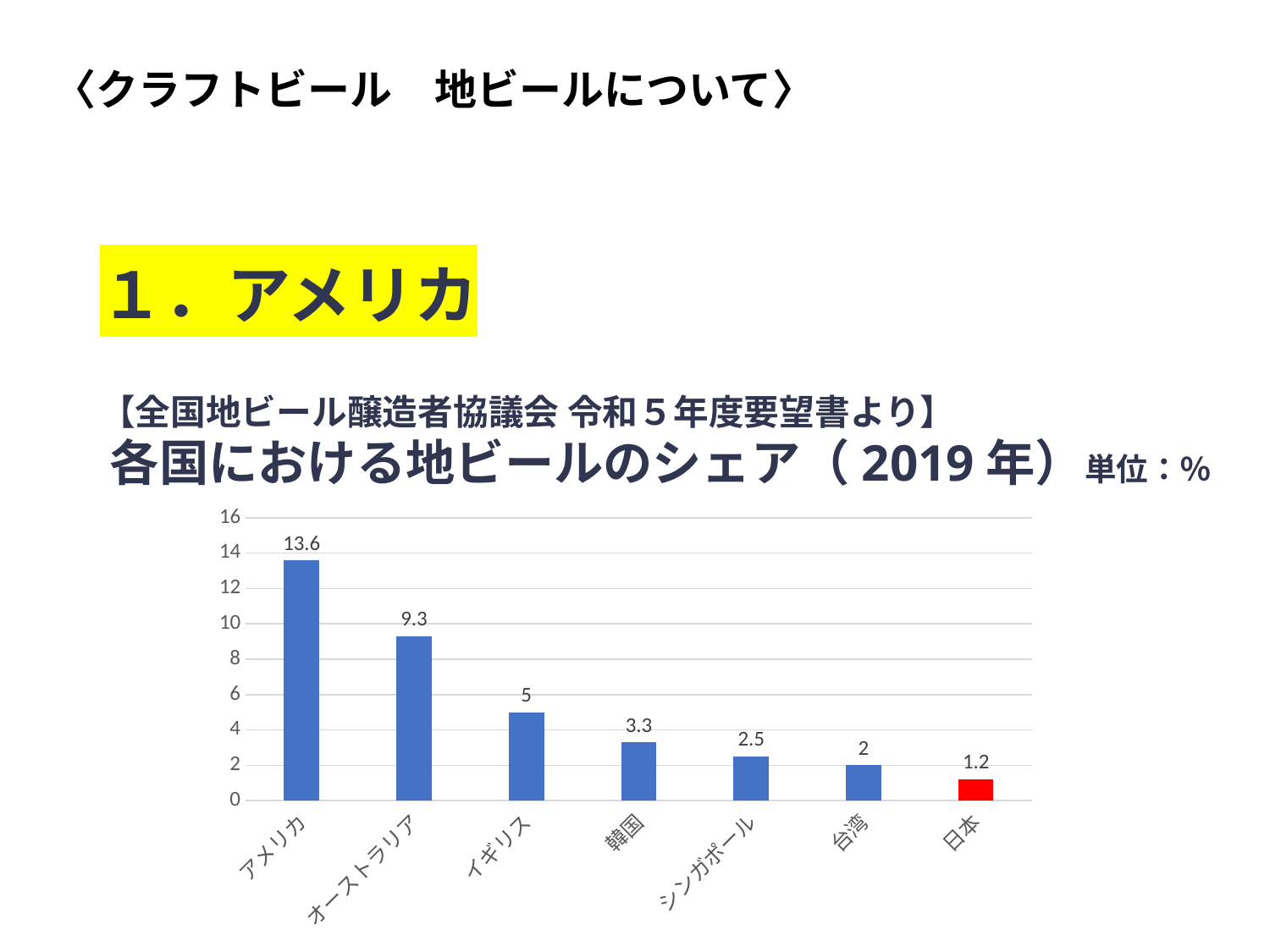
Which is larger, the value for 韓国 or the value for シンガポール? 韓国 What kind of chart is shown on the slide? bar chart How many countries are shown in the chart? 7 Which country has the lowest share? 日本 What is the value for 日本? 1.2 Which bar is coloured red? 日本 Is the value for イギリス greater or less than 4? greater What is the value for アメリカ? 13.6 What is the difference between the values for アメリカ and オーストラリア? 4.3 What is the value for オーストラリア? 9.3 Which country has the highest share? アメリカ What is the difference between the values for イギリス and 日本? 3.8